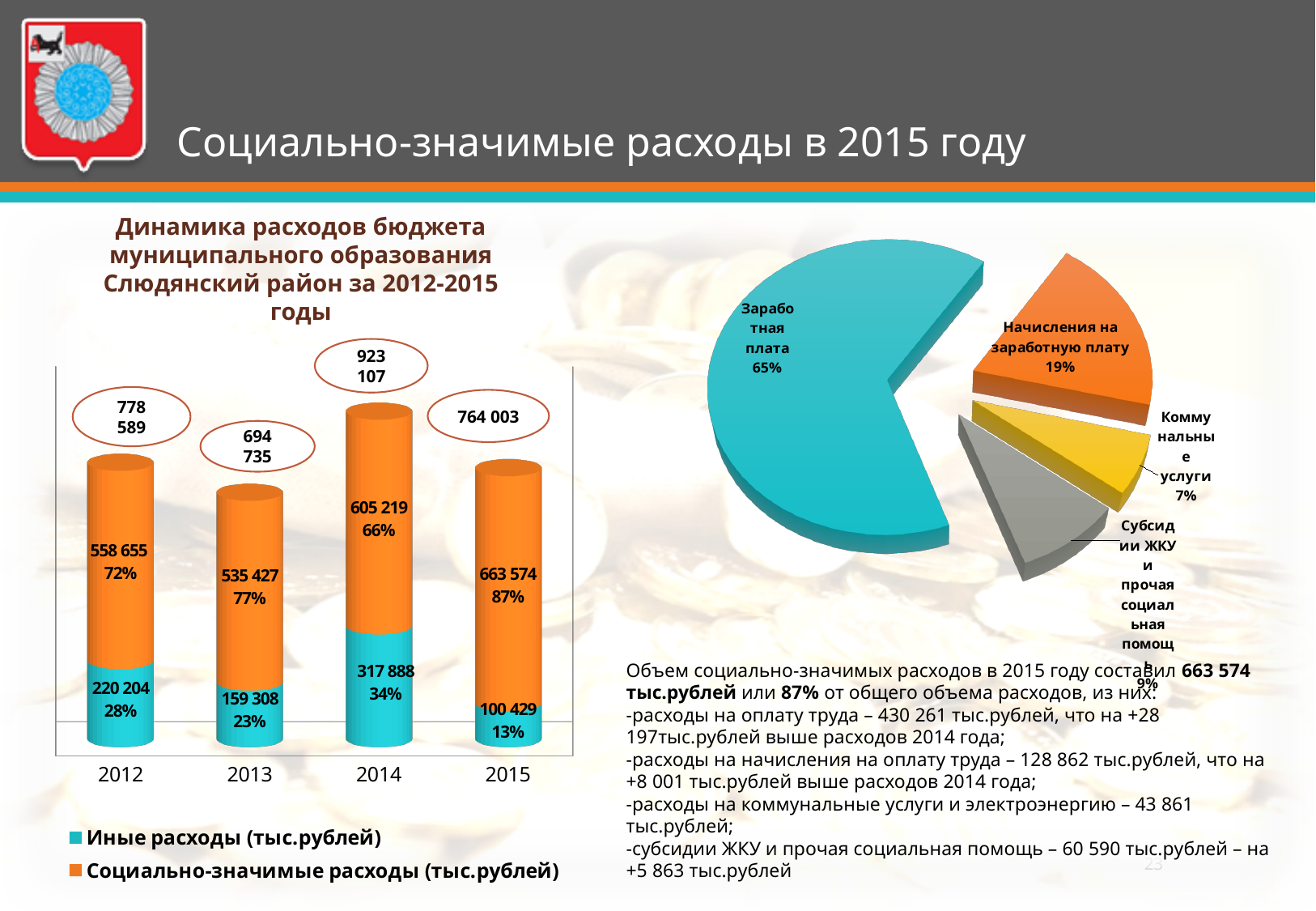
On the bar chart on the left, which year has the highest value for Иные расходы (тыс.рублей)? 2014 On the pie chart on the right, which category has the largest share? Заработная плата On the bar chart on the left, which year has the lowest value for Социально-значимые расходы (тыс.рублей)? 2013 On the bar chart on the left, what is the total shown above the stacked bar for 2014? 923 107 On the pie chart on the right, what share does Начисления на заработную плату have? 19% On the bar chart on the left, how many series does the legend list? 2 On the bar chart on the left, what is the value of Социально-значимые расходы (тыс.рублей) for 2015? 663 574 On the bar chart on the left, which is larger: Иные расходы in 2012 or in 2015? 2012 On the bar chart on the left, how many years are shown on the x axis? 4 What kind of chart is the chart on the right side of the slide? Pie chart On the bar chart on the left, what is the difference between Социально-значимые расходы in 2015 and in 2014? 58 355 On the bar chart on the left, what is the value of Иные расходы (тыс.рублей) for 2013? 159 308